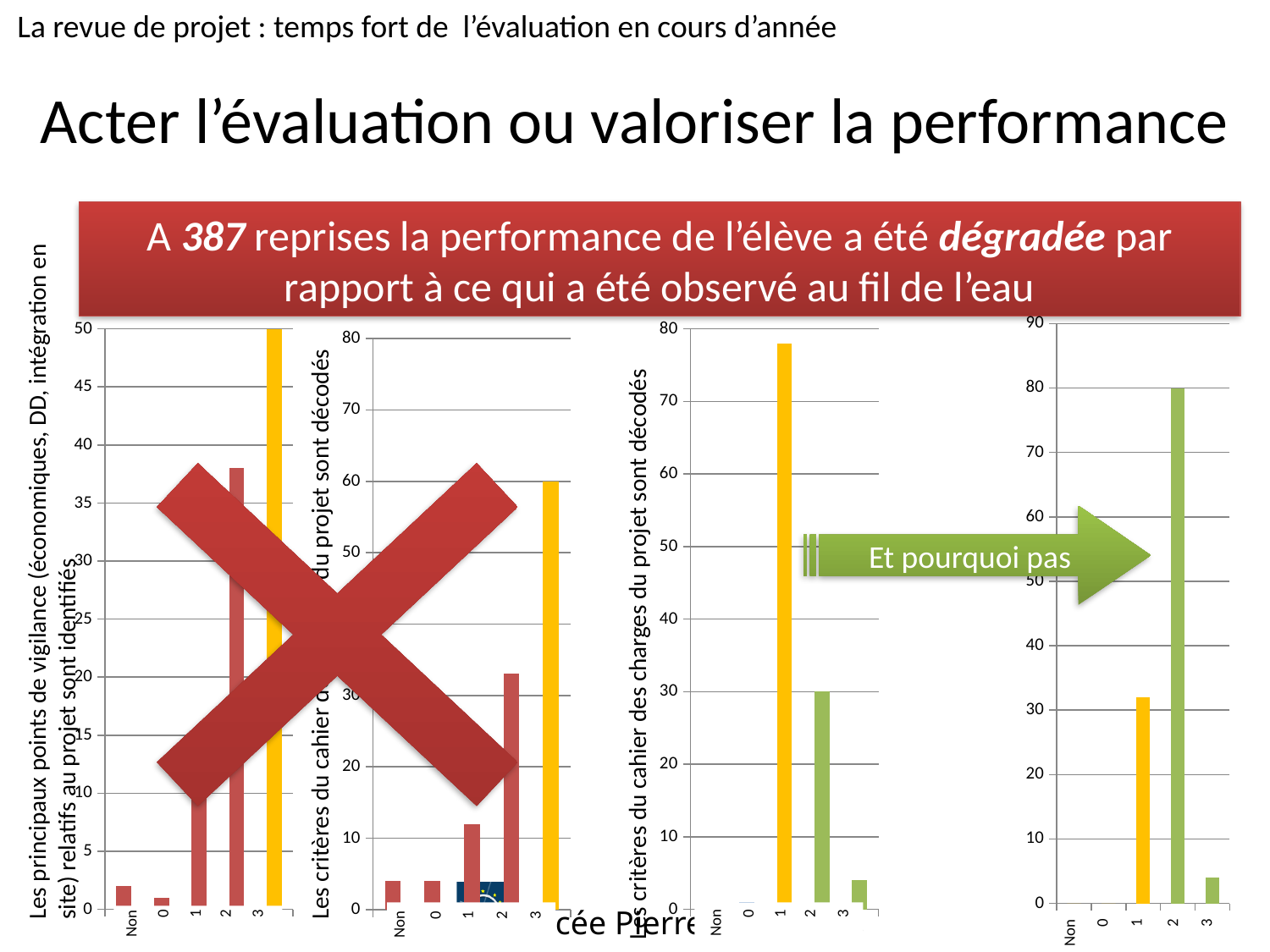
How many categories are shown on the x axis of the rightmost chart? 5 In the second chart from the left, which category has the tallest bar? 3 In the third chart from the left, is the value for category 3 greater or less than 10? less What kind of chart is the rightmost chart? bar chart In the rightmost chart, is the value for category 1 greater or less than 40? less In the rightmost chart, which is larger, the value for category 2 or category 3? 2 In the second chart from the left, what value does the bar for category 3 reach? 60 In the rightmost chart, which category has the tallest bar? 2 In the leftmost chart, which category has the tallest bar? 3 In the third chart from the left, is the value for category 1 greater or less than 70? greater